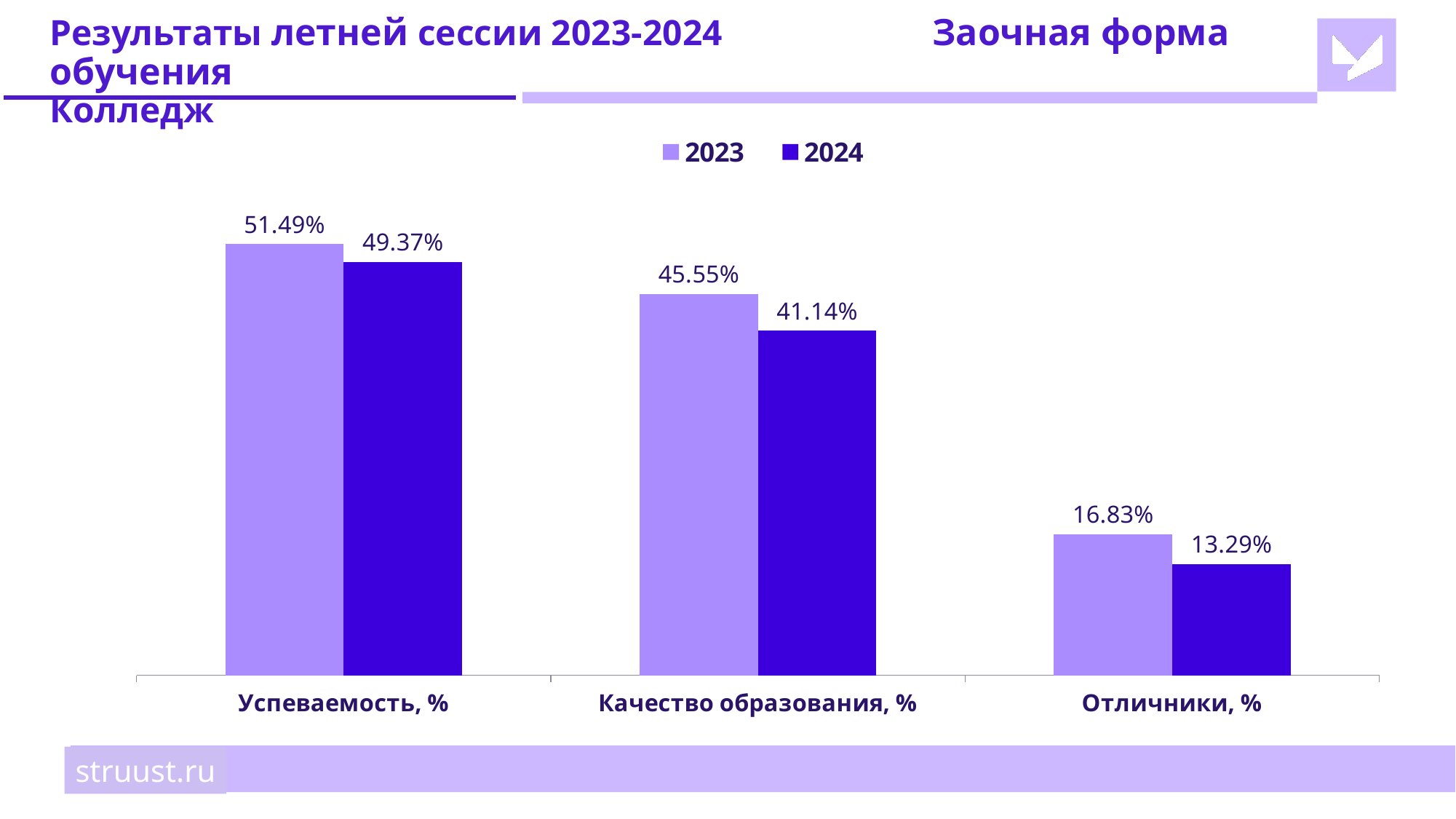
How many series does the chart legend list? 2 What is the difference between the 2023 and 2024 values in the Отличники, % category? 3.54% Which category has the highest value for the 2023 series? Успеваемость, % What is the difference between the 2023 and 2024 values in the Качество образования, % category? 4.41% Which category has the lowest value for the 2024 series? Отличники, % What kind of chart is shown on the slide? Bar chart What is the value for 2024 in the Отличники, % category? 13.29% How many categories are shown on the x axis of the chart? 3 What is the value for 2023 in the Отличники, % category? 16.83% What is the value for 2023 in the Успеваемость, % category? 51.49% What is the value for 2024 in the Качество образования, % category? 41.14% In the Успеваемость, % category, which series has the larger value, 2023 or 2024? 2023